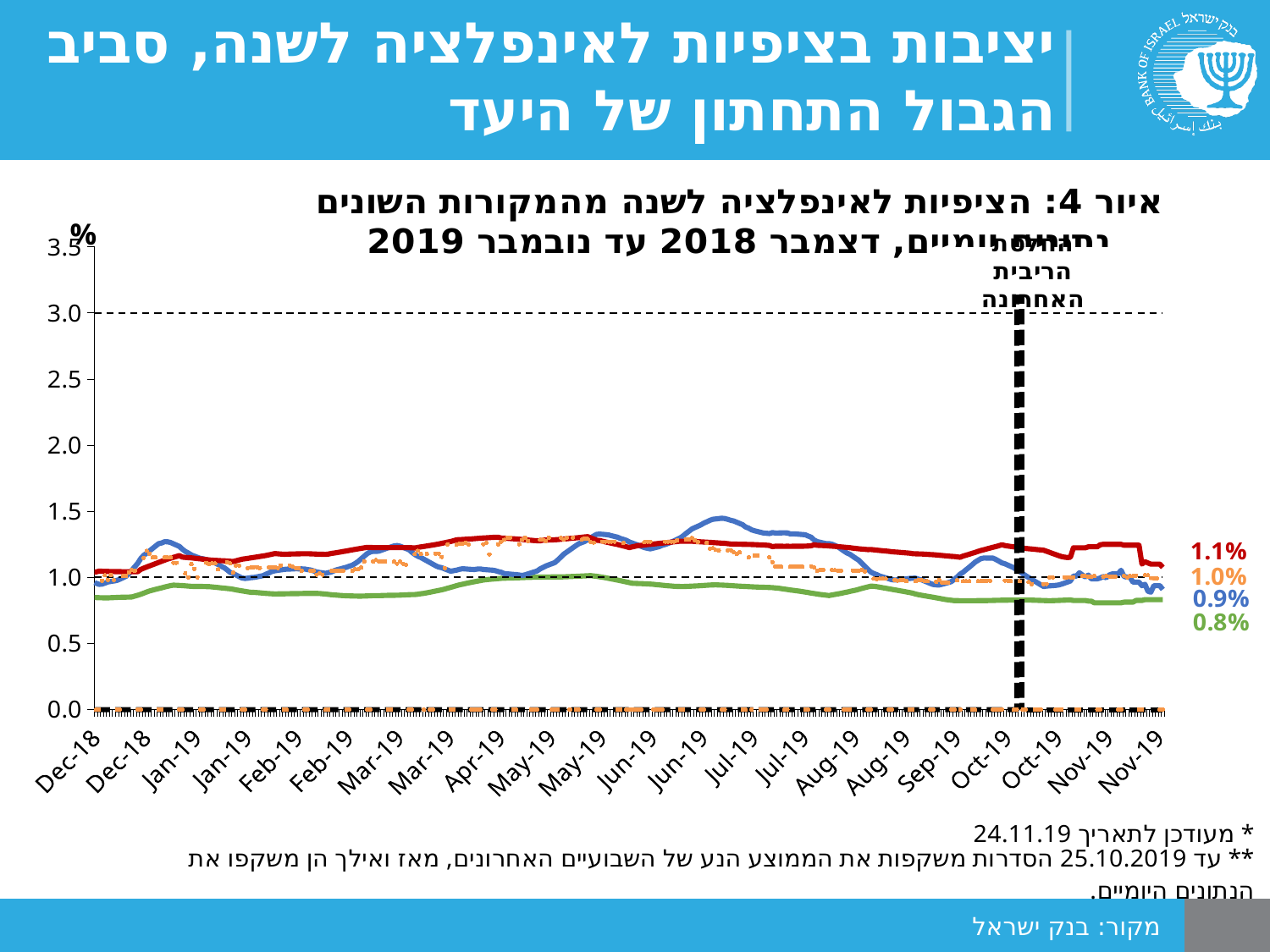
What is the value labelled at the end of the blue line? 0.9% At the end of the period, which is larger: the value of the red line or the value of the blue line? the red line What is the value labelled at the end of the red line? 1.1% What is the value labelled at the end of the green line? 0.8% Which line has the lowest value at the end of the period (Nov-19)? the green line (0.8%) What is the value labelled at the end of the orange dashed line? 1.0% Is the value of the green line in Dec-18 greater or less than 1.0? less What is the highest value shown on the y-axis of the chart? 3.5 What kind of chart is shown on the slide? line chart Which line has the highest value at the end of the period (Nov-19)? the red line (1.1%) What is the difference between the end values of the red line and the green line? 0.3%